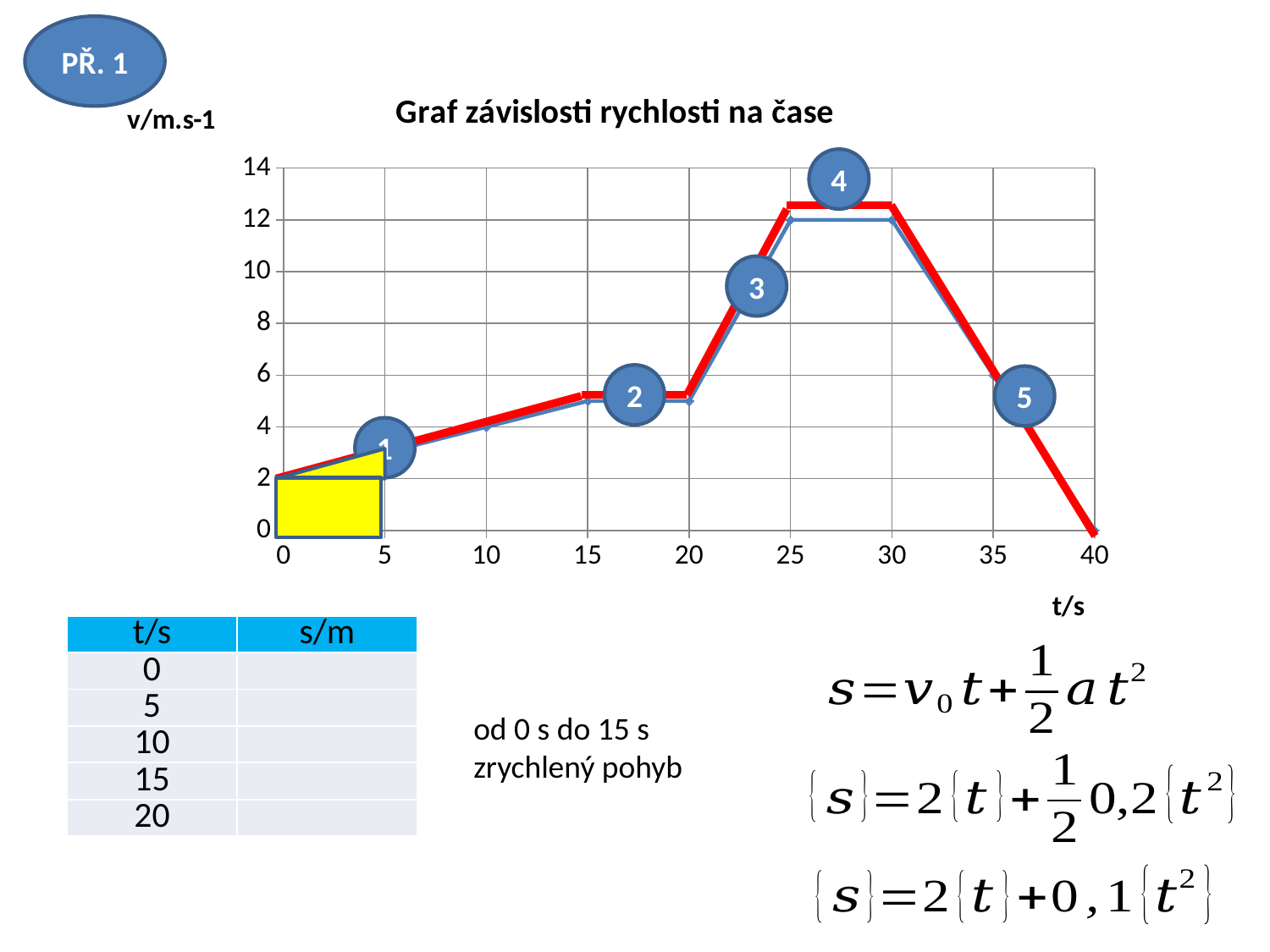
Which is larger, the velocity at t = 10 s or at t = 25 s? t = 25 s What is the velocity value at t = 10 s? 4 What is the velocity value at t = 0 s? 2 What kind of chart is shown on the slide? line chart Is the velocity at t = 15 s greater or less than 4? greater Does the velocity rise or fall between t = 30 s and t = 40 s? fall What is the title of the chart? Graf závislosti rychlosti na čase What is the velocity value at t = 40 s? 0 At which time does the velocity reach its lowest value? 40 What is the difference between the velocity at t = 25 s and the velocity at t = 0 s? 10 What is the velocity value at t = 25 s? 12 What is the highest velocity value reached on the chart? 12